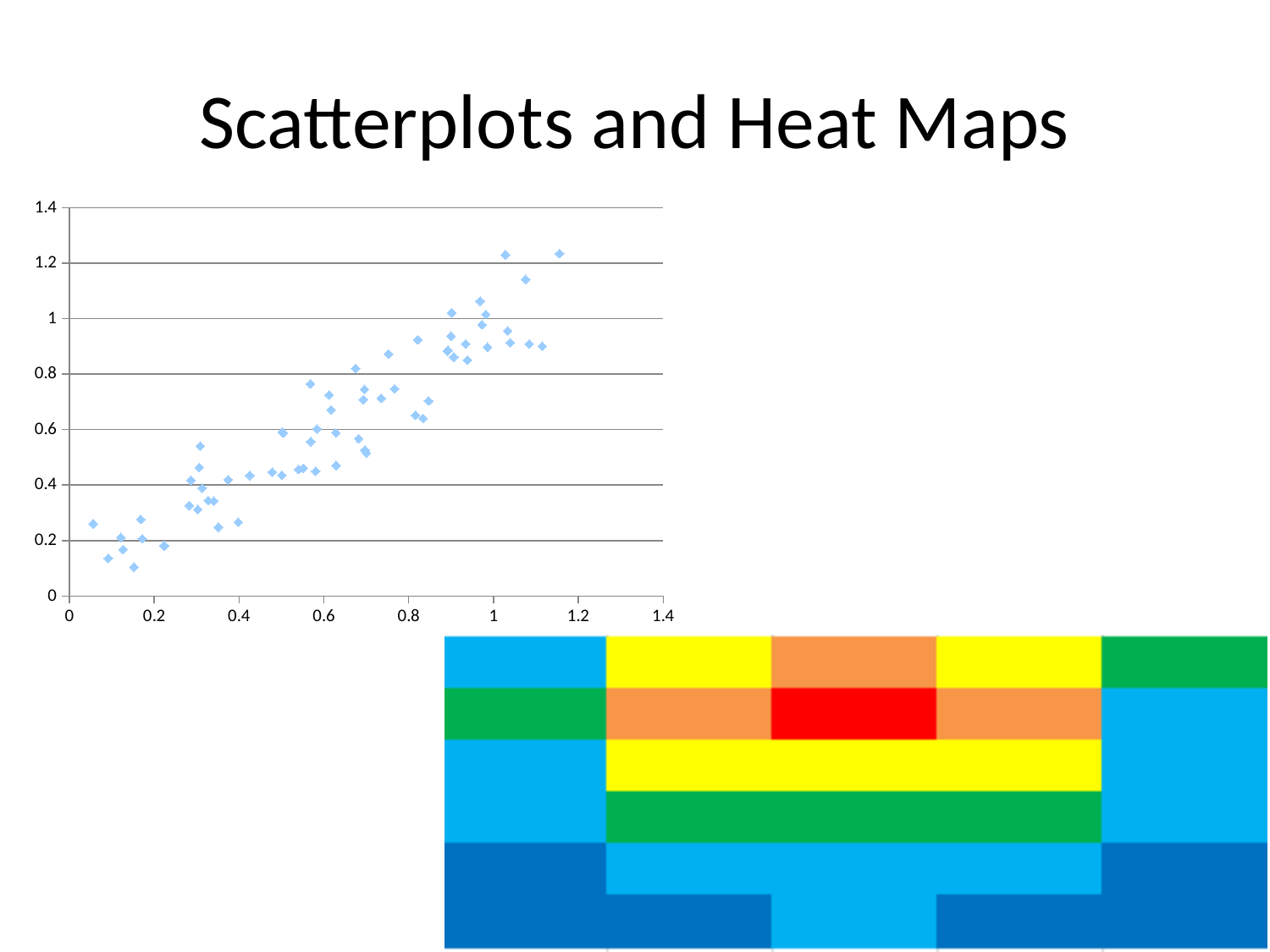
In the scatter plot, is the y value of the lowest point greater or less than 0.2? less How many columns of cells does the heat map at the bottom right have? 5 In the scatter plot, are there any points with an x value greater than 1.2? no How many red cells are in the heat map at the bottom right? 1 In the scatter plot, is the y value of the highest point greater or less than 1? greater What is the maximum value shown on the x axis of the scatter plot? 1.4 What kind of chart is shown on the top left of the slide? scatter plot How many rows of cells does the heat map at the bottom right have? 6 What is the title of the slide? Scatterplots and Heat Maps What is the maximum value shown on the y axis of the scatter plot? 1.4 In the scatter plot, do the y values generally rise or fall as x increases? rise